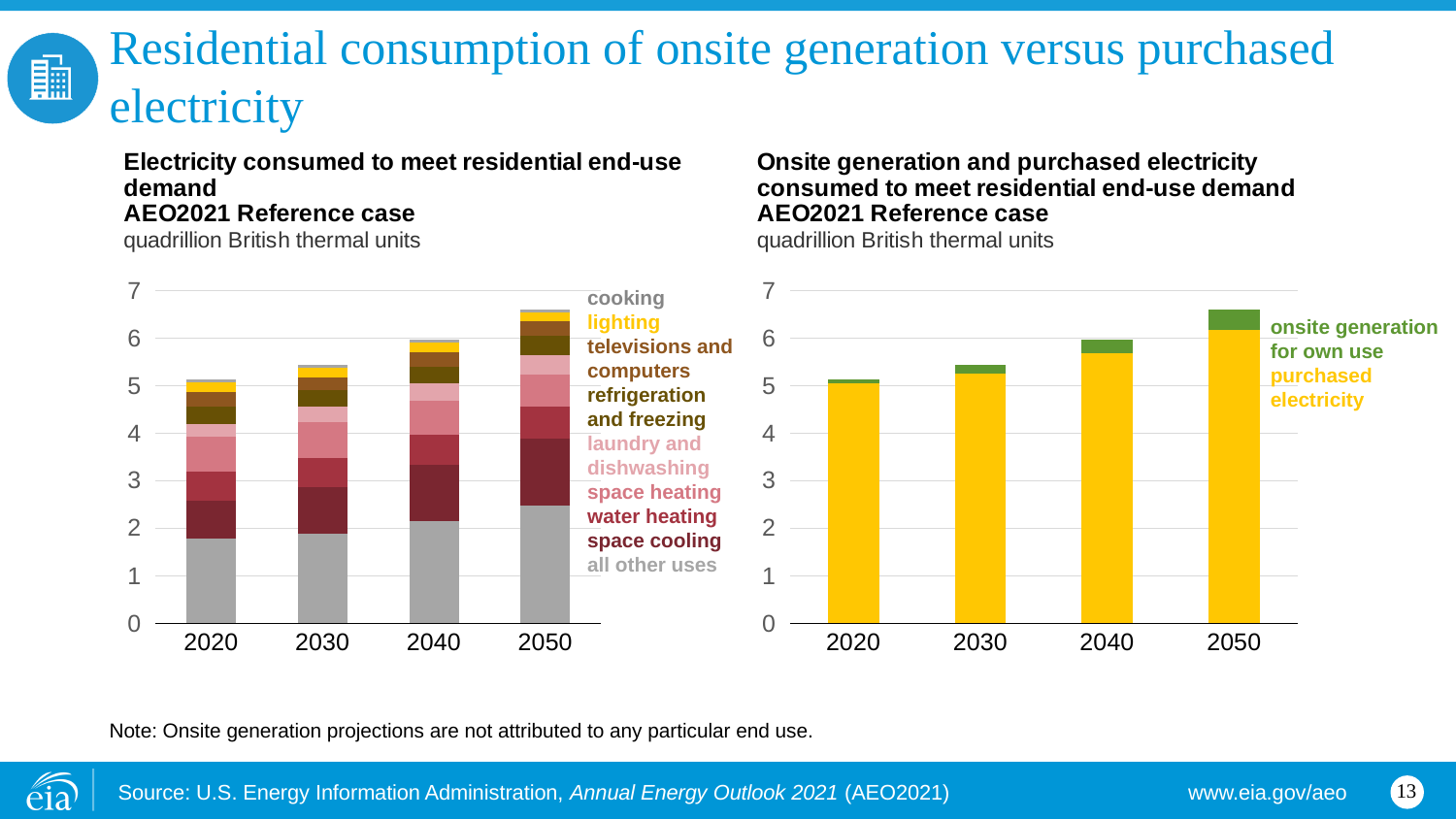
In the right chart, is onsite generation for own use in 2050 greater or less than 1 quadrillion British thermal units? less What kind of chart is the left chart, 'Electricity consumed to meet residential end-use demand'? stacked bar chart How many years are shown on the x axis of the right chart, 'Onsite generation and purchased electricity consumed to meet residential end-use demand'? 4 How many end-use series does the legend of the left chart list? 9 In the right chart, which is larger in 2050: purchased electricity or onsite generation for own use? purchased electricity In the left chart, is the total for 2050 greater or less than 6 quadrillion British thermal units? greater In the right chart, which year has the lowest total consumption? 2020 In the left chart, does total electricity consumption rise or fall from 2020 to 2050? rise In the left chart, which year has the highest total electricity consumption? 2050 How many series does the legend of the right chart list? 2 In the left chart, which is larger: the total for 2020 or the total for 2050? 2050 What unit is used on the y axis of both charts? quadrillion British thermal units